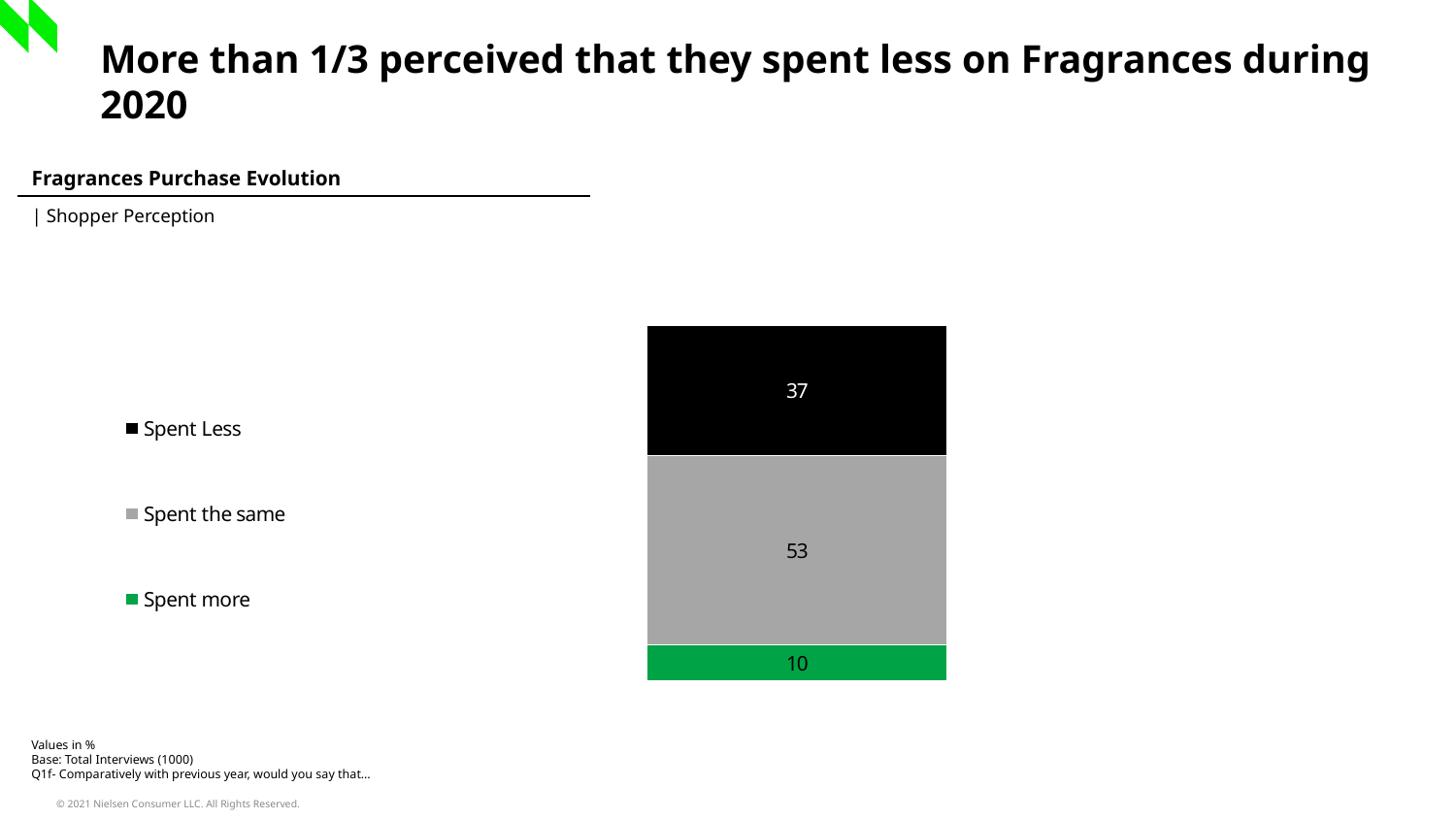
What value is shown for Spent more? 10 What is the difference between Spent Less and Spent more? 27 What value is shown for Spent Less? 37 What colour represents Spent more in the chart? Green What is the difference between Spent the same and Spent Less? 16 What kind of chart is shown? Stacked bar chart Which segment has the lowest value? Spent more What is the total of the stacked bar? 100 Which is larger, Spent Less or Spent more? Spent Less How many series does the legend list? 3 Which segment has the highest value? Spent the same What value is shown for Spent the same? 53